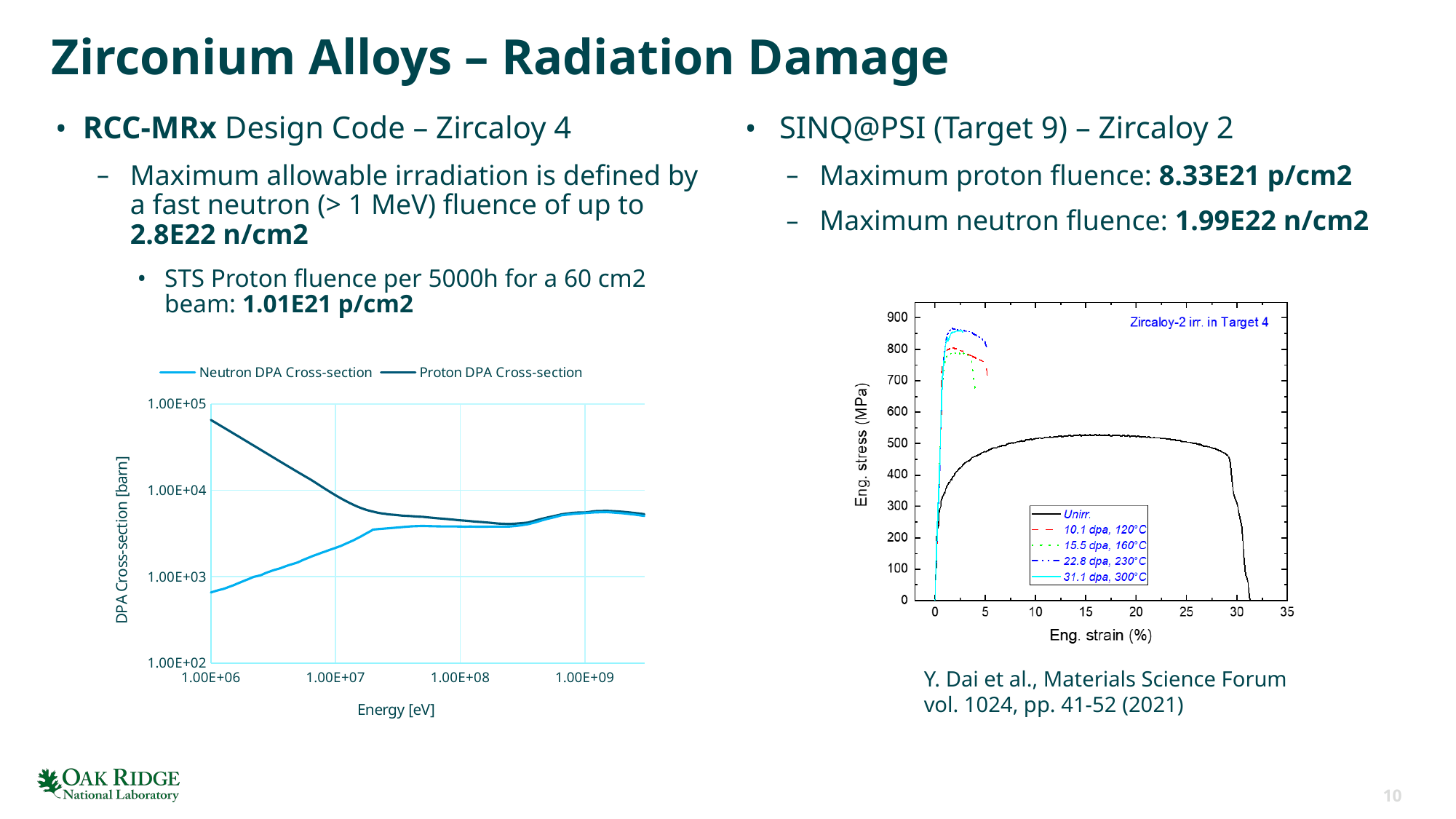
On the right chart (Zircaloy-2 irr. in Target 4), how many series does the legend list? 5 What kind of chart is the left chart (DPA cross-section vs energy)? Line chart On the right chart, which series reaches the largest engineering strain? Unirr. On the left chart, does the Proton DPA Cross-section rise or fall as energy increases from 1.00E+06 to 1.00E+08 eV? Fall On the right chart, what is the label of the x axis? Eng. strain (%) On the left chart, does the Neutron DPA Cross-section rise or fall as energy increases from 1.00E+06 to 1.00E+08 eV? Rise On the right chart, is the maximum engineering stress of the Unirr. curve greater or less than 600 MPa? less On the left chart, at 1.00E+06 eV, is the Proton DPA Cross-section greater or less than 1.00E+04 barn? greater On the left chart, what is the label of the y axis? DPA Cross-section [barn] On the left chart, at 1.00E+06 eV, is the Neutron DPA Cross-section greater or less than 1.00E+03 barn? less On the left chart, how many series does the legend list? 2 On the left chart, at 1.00E+06 eV, which series has the higher DPA cross-section? Proton DPA Cross-section